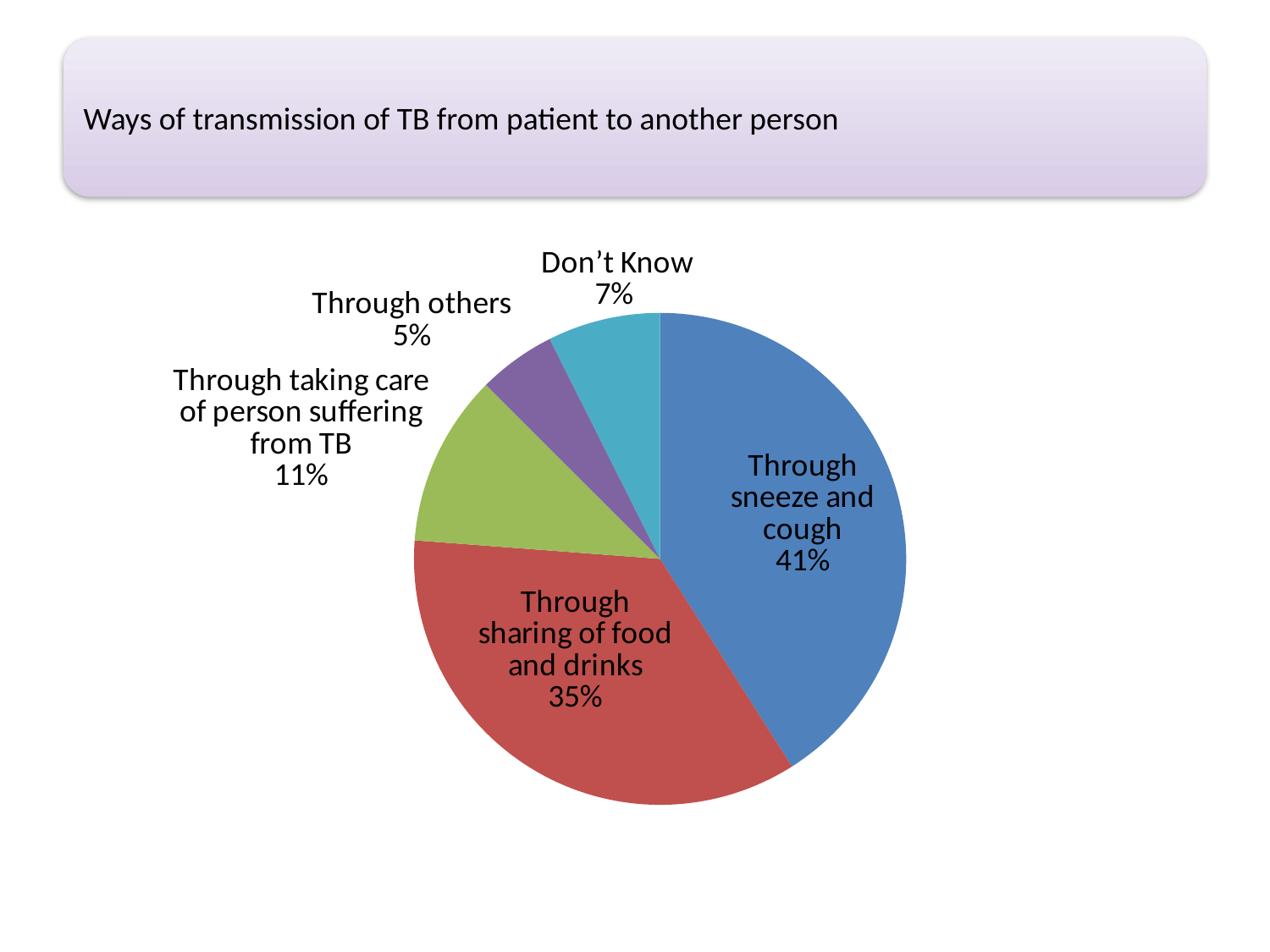
What is the difference in percentage points between 'Through sneeze and cough' and 'Through sharing of food and drinks'? 6% Which category has the largest slice of the pie? Through sneeze and cough What share of the pie is 'Through others'? 5% What is the title shown above the chart? Ways of transmission of TB from patient to another person What share of the pie is 'Through sneeze and cough'? 41% Which is larger: 'Don't Know' or 'Through others'? Don't Know What share of the pie is 'Don't Know'? 7% How many categories are shown in the pie chart? 5 Which category has the smallest slice of the pie? Through others What kind of chart is shown on the slide? Pie chart